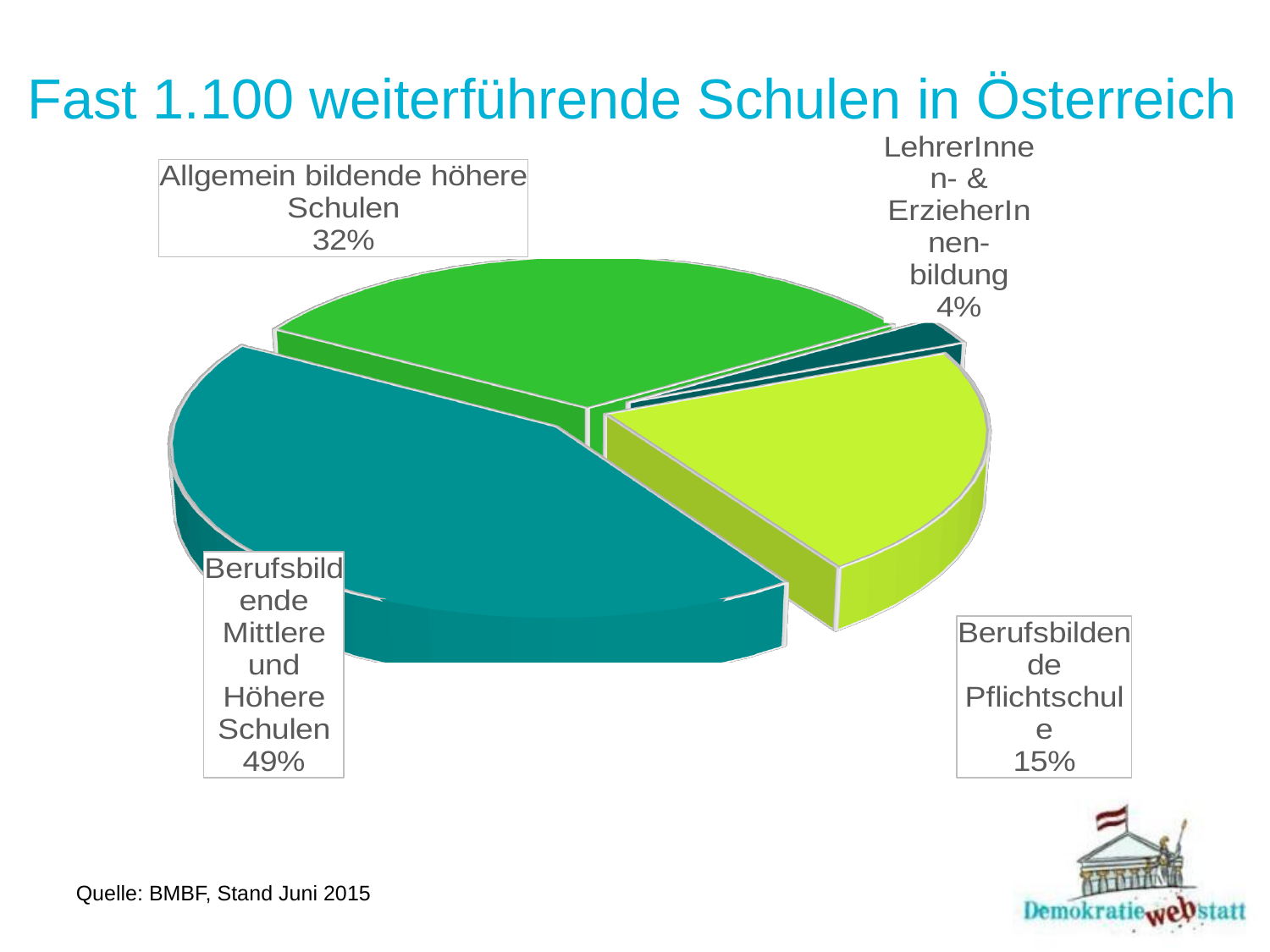
Which category has the largest slice of the pie? Berufsbildende Mittlere und Höhere Schulen What share of the pie does Berufsbildende Pflichtschule have? 15% What share of the pie does Allgemein bildende höhere Schulen have? 32% What share of the pie does LehrerInnen- & ErzieherInnenbildung have? 4% Which category has the smallest slice of the pie? LehrerInnen- & ErzieherInnenbildung What kind of chart is shown on the slide? Pie chart Which is larger: the share for Berufsbildende Pflichtschule or the share for Allgemein bildende höhere Schulen? Allgemein bildende höhere Schulen What is the title of the slide? Fast 1.100 weiterführende Schulen in Österreich What source is cited for the chart data? BMBF, Stand Juni 2015 How many categories are shown in the pie chart? 4 What is the difference in percentage points between Berufsbildende Mittlere und Höhere Schulen and Allgemein bildende höhere Schulen? 17 percentage points